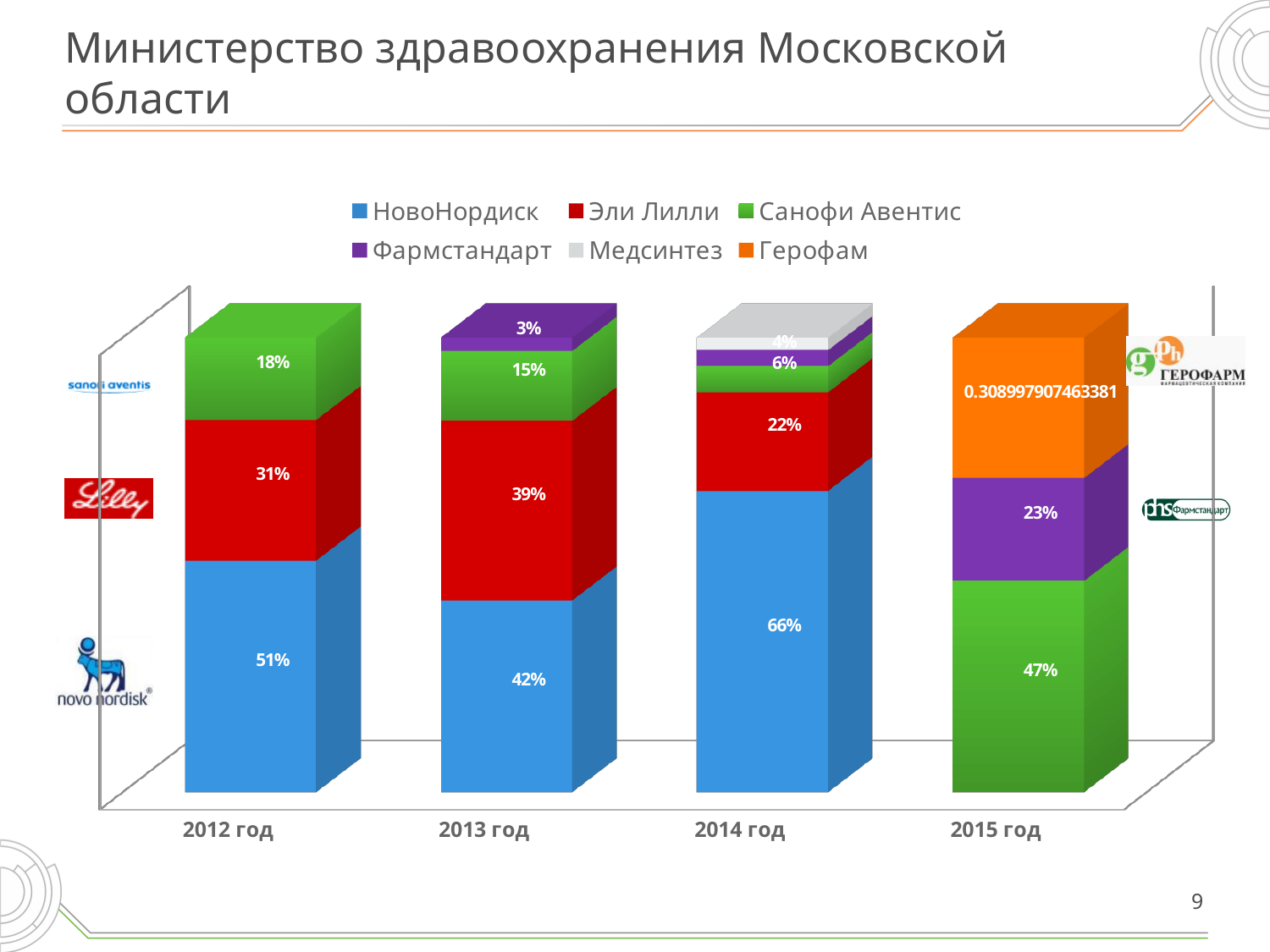
What is the value for Санофи Авентис in 2015 год? 47% How many years are shown on the x axis? 4 What share does НовоНордиск have in 2012 год? 51% How many series does the legend list? 6 What is the value for Эли Лилли in 2013 год? 39% What is the difference between НовоНордиск and Эли Лилли in 2012 год? 20% Which is larger: Эли Лилли in 2013 год or Эли Лилли in 2014 год? Эли Лилли in 2013 год What is the value for Фармстандарт in 2014 год? 4% What is the value for Фармстандарт in 2015 год? 23% What kind of chart is shown on the slide? Stacked bar chart In which year is the НовоНордиск segment the largest? 2014 год